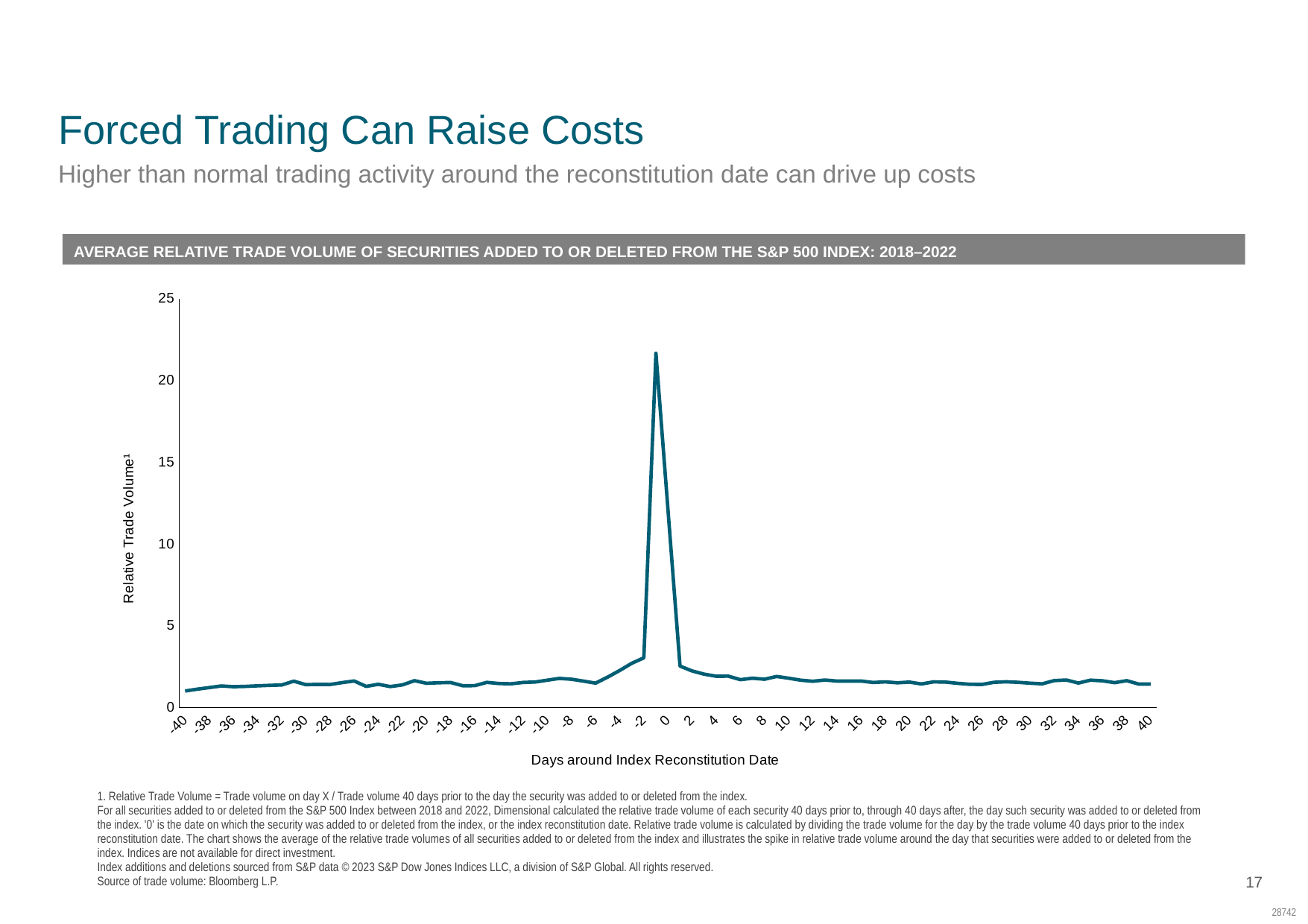
Is the relative trade volume on day 2 greater or less than 10? less Is the relative trade volume on day 40 greater or less than 5? less Which has the larger relative trade volume, day 0 or day 20? day 0 What kind of chart is shown on the slide? line chart Does the relative trade volume rise or fall from day 0 to day 2? fall What is the label of the y axis? Relative Trade Volume Is the relative trade volume on day -40 greater or less than 5? less On which day around the index reconstitution date is the relative trade volume highest? -1 Which has the larger relative trade volume, day -40 or day 0? day 0 What is the label of the x axis? Days around Index Reconstitution Date